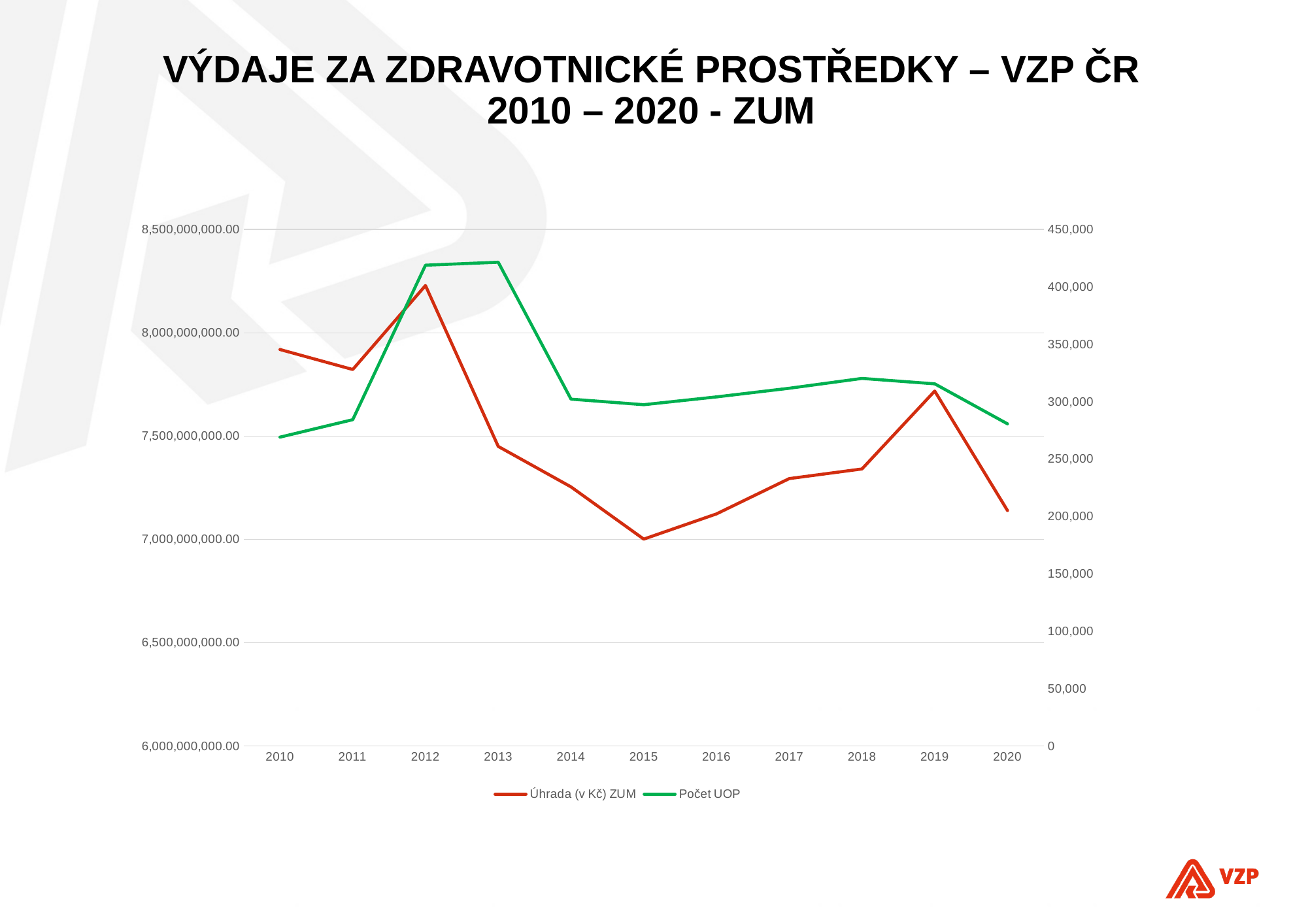
Which year has the larger Úhrada (v Kč) ZUM value, 2010 or 2020? 2010 In which year is the Úhrada (v Kč) ZUM series at its highest? 2012 What colour is the line for the Počet UOP series? green How many series does the legend list? 2 Is the Úhrada (v Kč) ZUM value for 2012 greater or less than 8,000,000,000.00? greater Is the Úhrada (v Kč) ZUM value for 2015 greater or less than 7,500,000,000.00? less What kind of chart is shown on the slide? line chart In which year is the Úhrada (v Kč) ZUM series at its lowest? 2015 Does the Úhrada (v Kč) ZUM series rise or fall from 2012 to 2015? fall How many years are plotted along the x axis? 11 In which year is the Počet UOP series at its lowest? 2010 Is the Počet UOP value for 2020 greater or less than 300,000? less